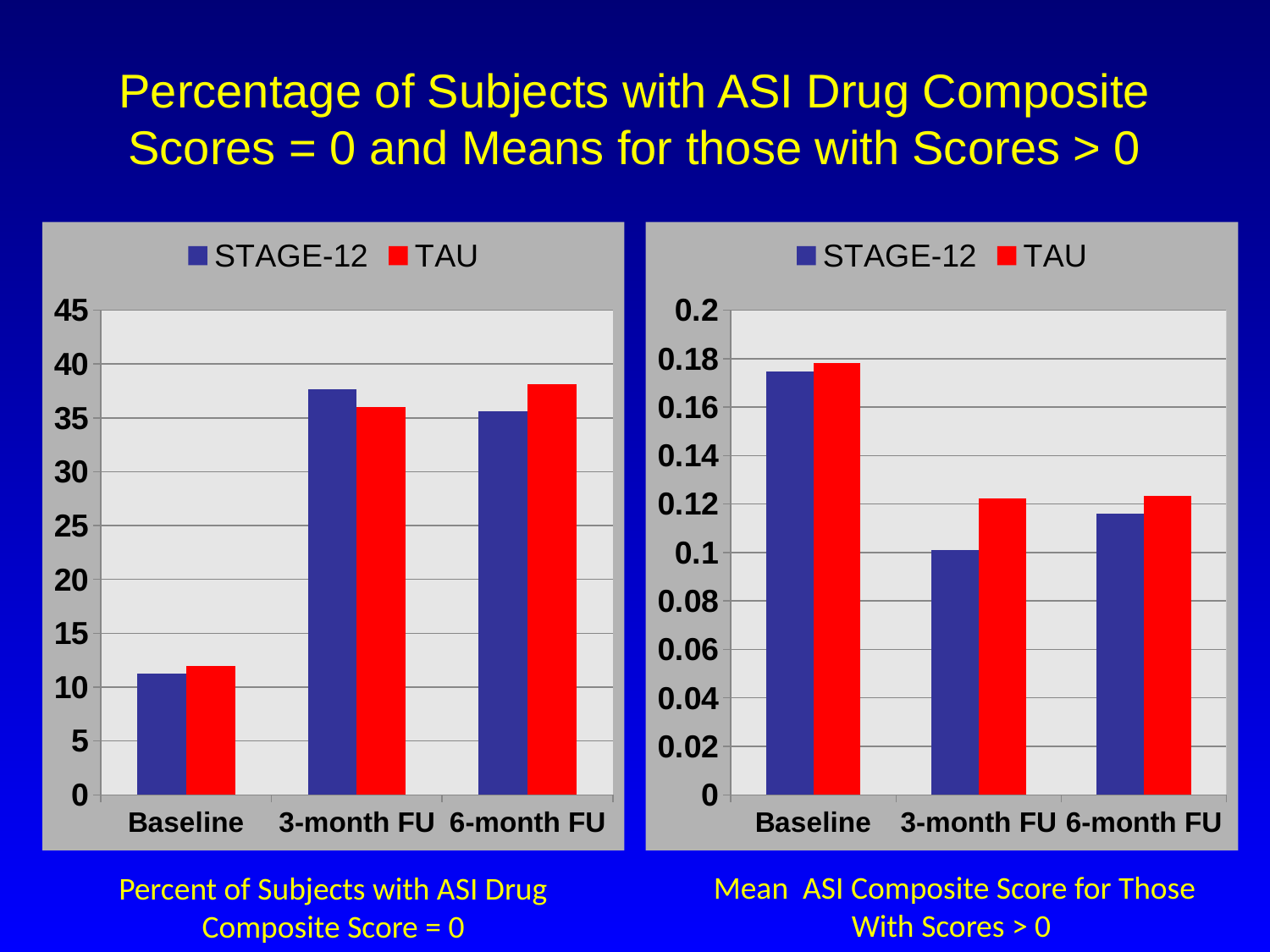
In the left chart (Percent of Subjects with ASI Drug Composite Score = 0), at which category is the TAU value lowest? Baseline How many categories are shown on the x axis of the left chart (Percent of Subjects with ASI Drug Composite Score = 0)? 3 In the left chart (Percent of Subjects with ASI Drug Composite Score = 0), which series is larger at 6-month FU, STAGE-12 or TAU? TAU In the left chart (Percent of Subjects with ASI Drug Composite Score = 0), is the STAGE-12 value at Baseline greater or less than 15? less What kind of chart is the left chart (Percent of Subjects with ASI Drug Composite Score = 0)? bar chart In the right chart (Mean ASI Composite Score for Those With Scores > 0), is the STAGE-12 value at Baseline greater or less than 0.16? greater In the right chart (Mean ASI Composite Score for Those With Scores > 0), at which category is the STAGE-12 value lowest? 3-month FU In the right chart (Mean ASI Composite Score for Those With Scores > 0), which series is larger at 3-month FU, STAGE-12 or TAU? TAU How many series does the legend of the right chart (Mean ASI Composite Score for Those With Scores > 0) list? 2 In the left chart (Percent of Subjects with ASI Drug Composite Score = 0), at which category is the STAGE-12 value highest? 3-month FU In the right chart (Mean ASI Composite Score for Those With Scores > 0), at which category is the TAU value highest? Baseline In the right chart (Mean ASI Composite Score for Those With Scores > 0), does the STAGE-12 value rise or fall from Baseline to 3-month FU? fall